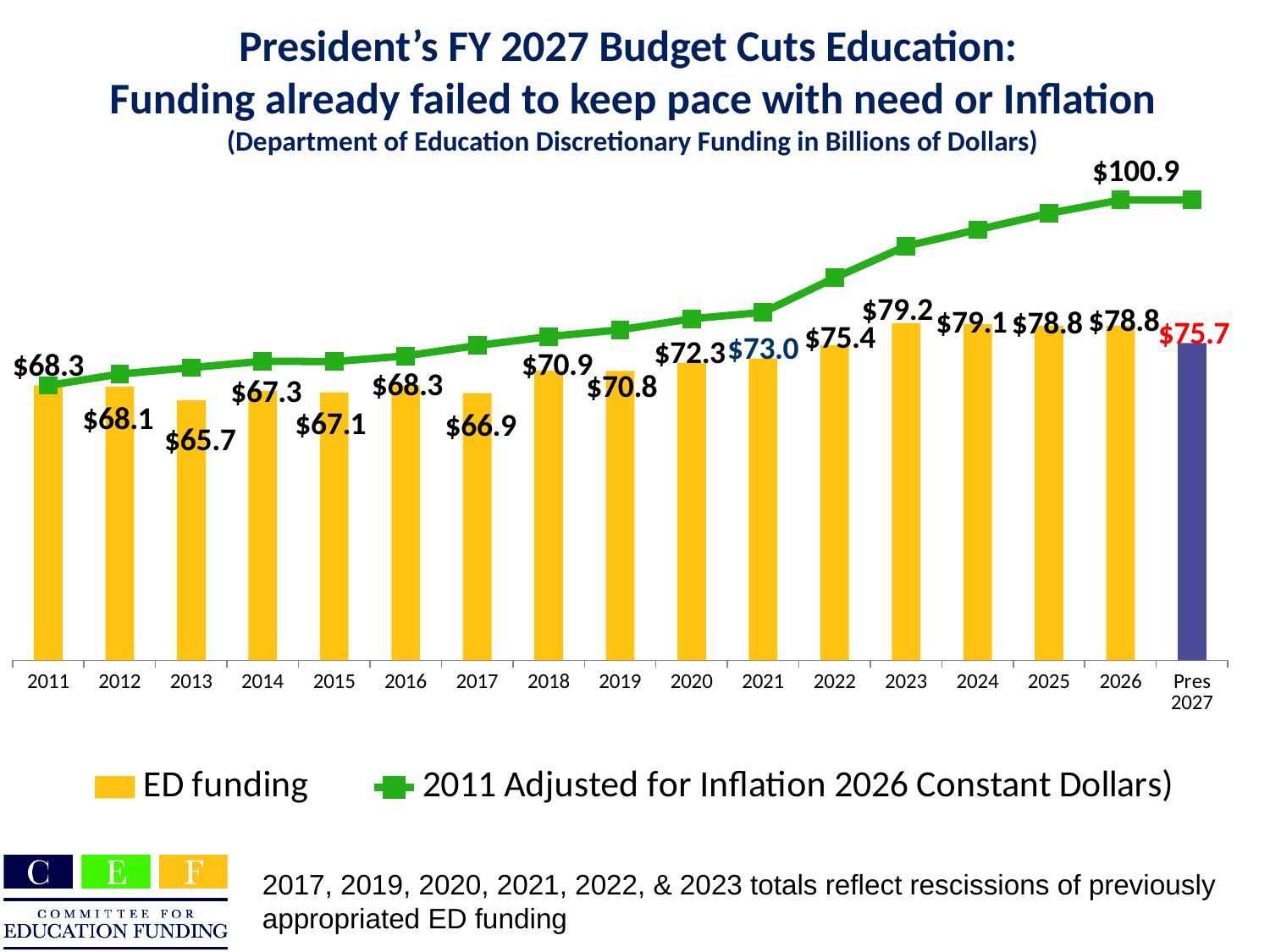
Which year has the lowest ED funding bar? 2013 Which year has the highest ED funding bar? 2023 What kind of chart is this? Combined bar and line chart What is the ED funding value for Pres 2027? $75.7 What is the ED funding value for 2013? $65.7 Which is larger, ED funding in 2018 or in 2022? 2022 What is the difference between ED funding in 2026 and Pres 2027? $3.1 How many series does the legend list? 2 What is the value of the 2011 Adjusted for Inflation line at 2026? $100.9 Does the 2011 Adjusted for Inflation line generally rise or fall from 2011 to 2026? Rise What is the difference between the 2011 Adjusted for Inflation value in 2026 and the ED funding value in 2026? $22.1 How many categories are shown on the x axis? 17